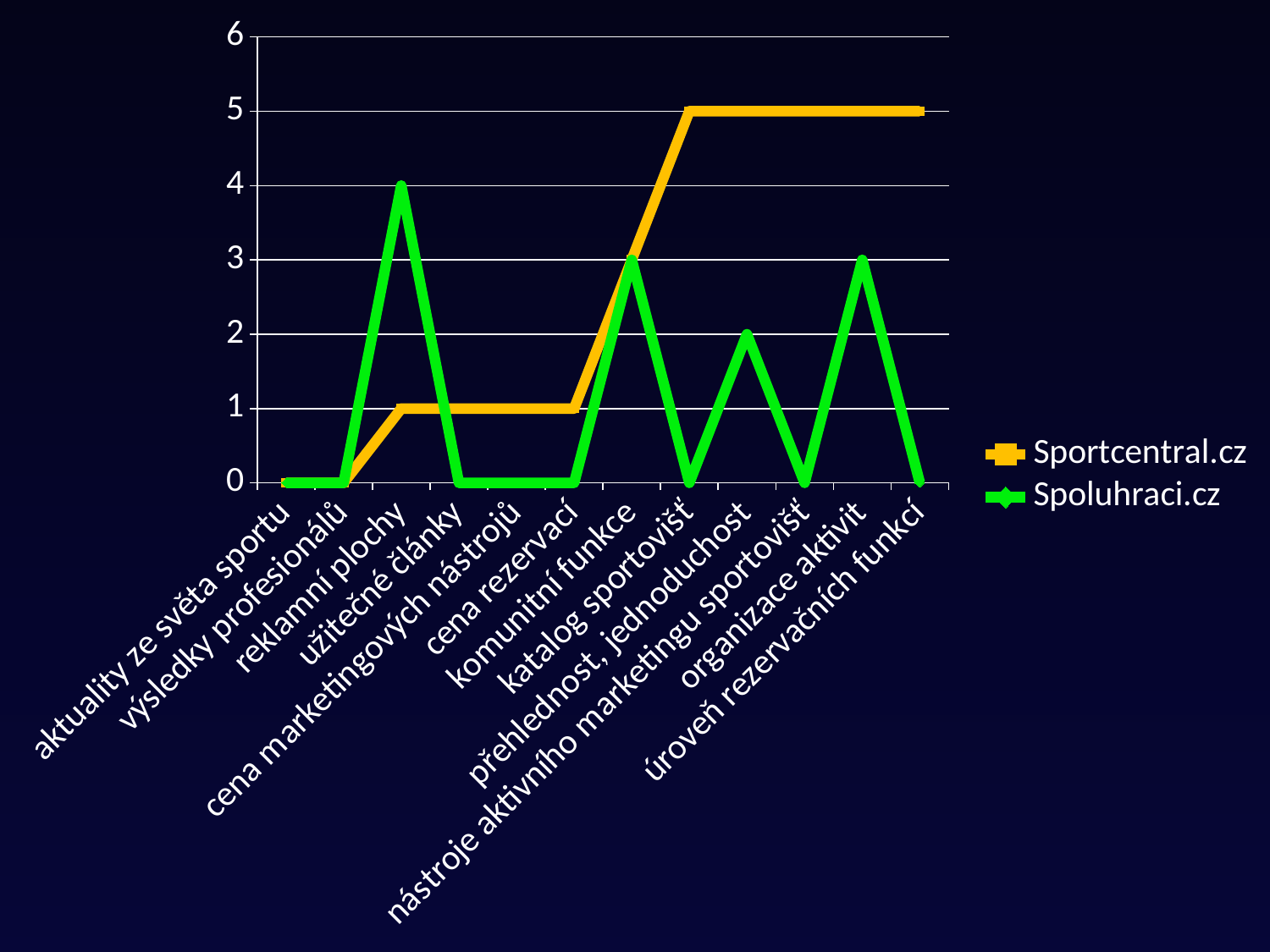
Is the value for Sportcentral.cz at úroveň rezervačních funkcí greater or less than 4? greater What is the value for Sportcentral.cz at komunitní funkce? 3 What is the difference between Sportcentral.cz and Spoluhraci.cz at organizace aktivit? 2 How many categories are shown on the x axis? 12 Which series has the higher value at reklamní plochy? Spoluhraci.cz What kind of chart is shown on the slide? line chart What is the value for Sportcentral.cz at katalog sportovišť? 5 At which category does Spoluhraci.cz reach its highest value? reklamní plochy What is the value for Spoluhraci.cz at přehlednost, jednoduchost? 2 What colour is the line for Spoluhraci.cz? green What is the value for Spoluhraci.cz at reklamní plochy? 4 How many series does the legend list? 2